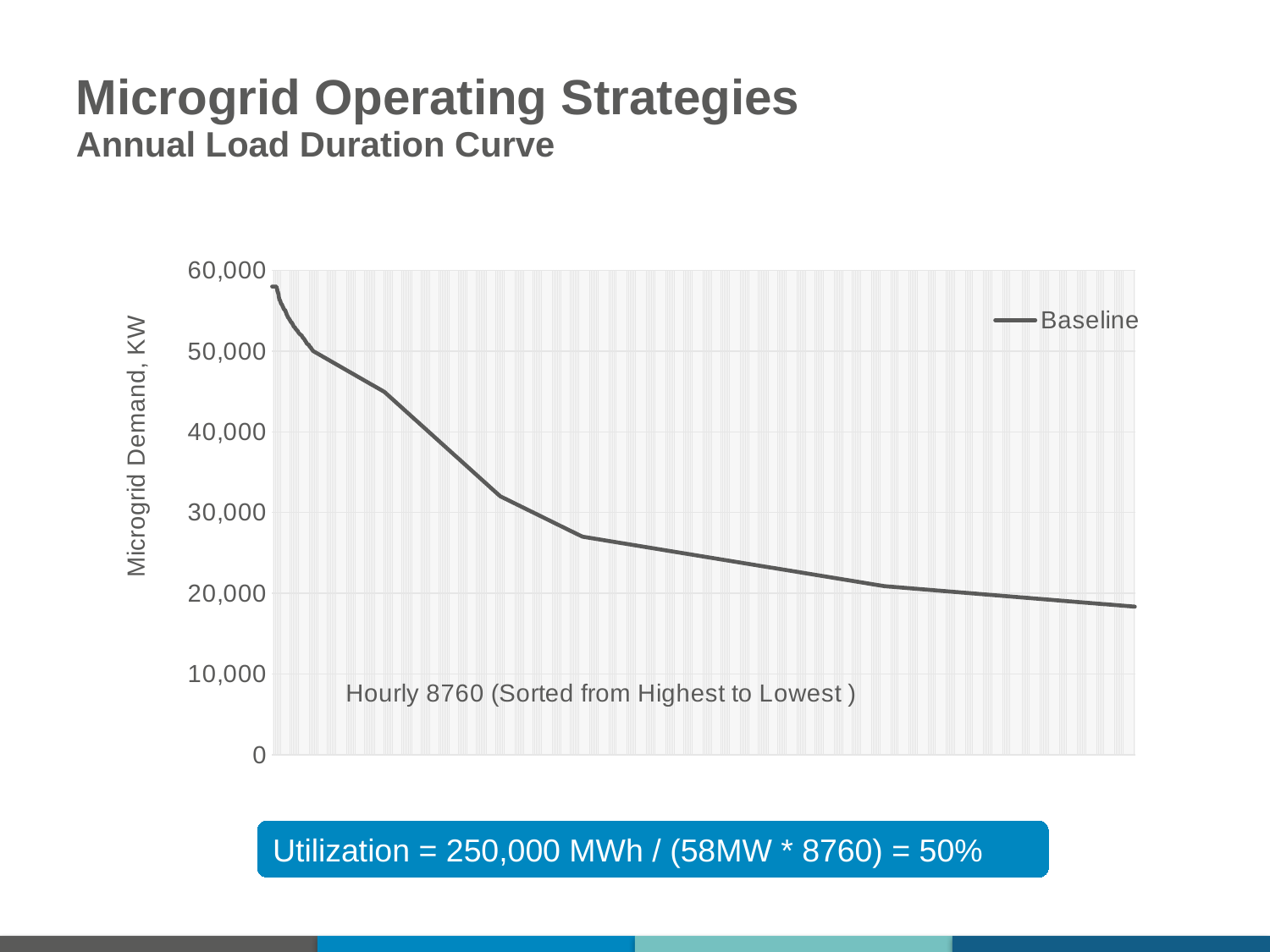
What is the title of the chart's vertical axis? Microgrid Demand, KW What kind of chart is shown on the slide? line chart How many series does the chart's legend list? 1 Is the value of the Baseline line at the far left of the chart greater or less than 60,000? less What is the name of the series shown in the chart's legend? Baseline Do the values of the Baseline line rise or fall from left to right along the x axis? fall Is the value of the Baseline line at the far left of the chart greater or less than 50,000? greater Is the value of the Baseline line at the far right of the chart greater or less than 10,000? greater